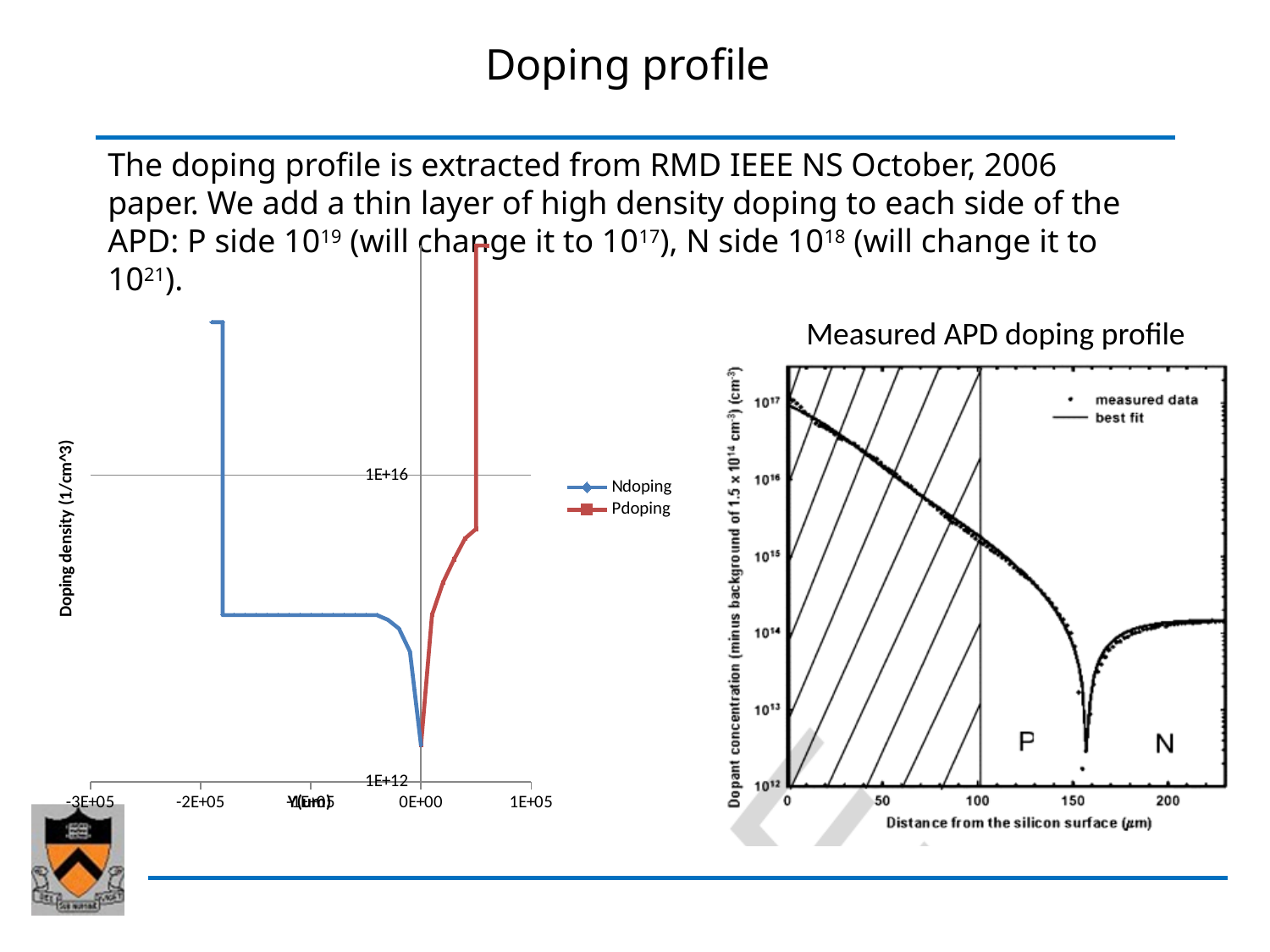
What is the title of the chart on the right side of the slide? Measured APD doping profile On the right chart (Measured APD doping profile), how many entries does the legend list? 2 On the left chart, what are the names of the two series in the legend? Ndoping and Pdoping On the left chart, which series is plotted in blue? Ndoping On the right chart (Measured APD doping profile), does the dopant concentration rise or fall as distance increases from 0 to about 150 μm? fall On the left chart, is the peak value of the Pdoping series greater or less than 1E+16? greater On the left chart, how many series does the legend list? 2 On the right chart (Measured APD doping profile), is the dopant concentration at a distance of 0 μm greater or less than 10^16? greater What kind of chart is the left chart with the Ndoping and Pdoping series? Line chart On the left chart, which series reaches the higher maximum doping density, Ndoping or Pdoping? Pdoping On the left chart, is the flat plateau value of the Ndoping series greater or less than 1E+16? less